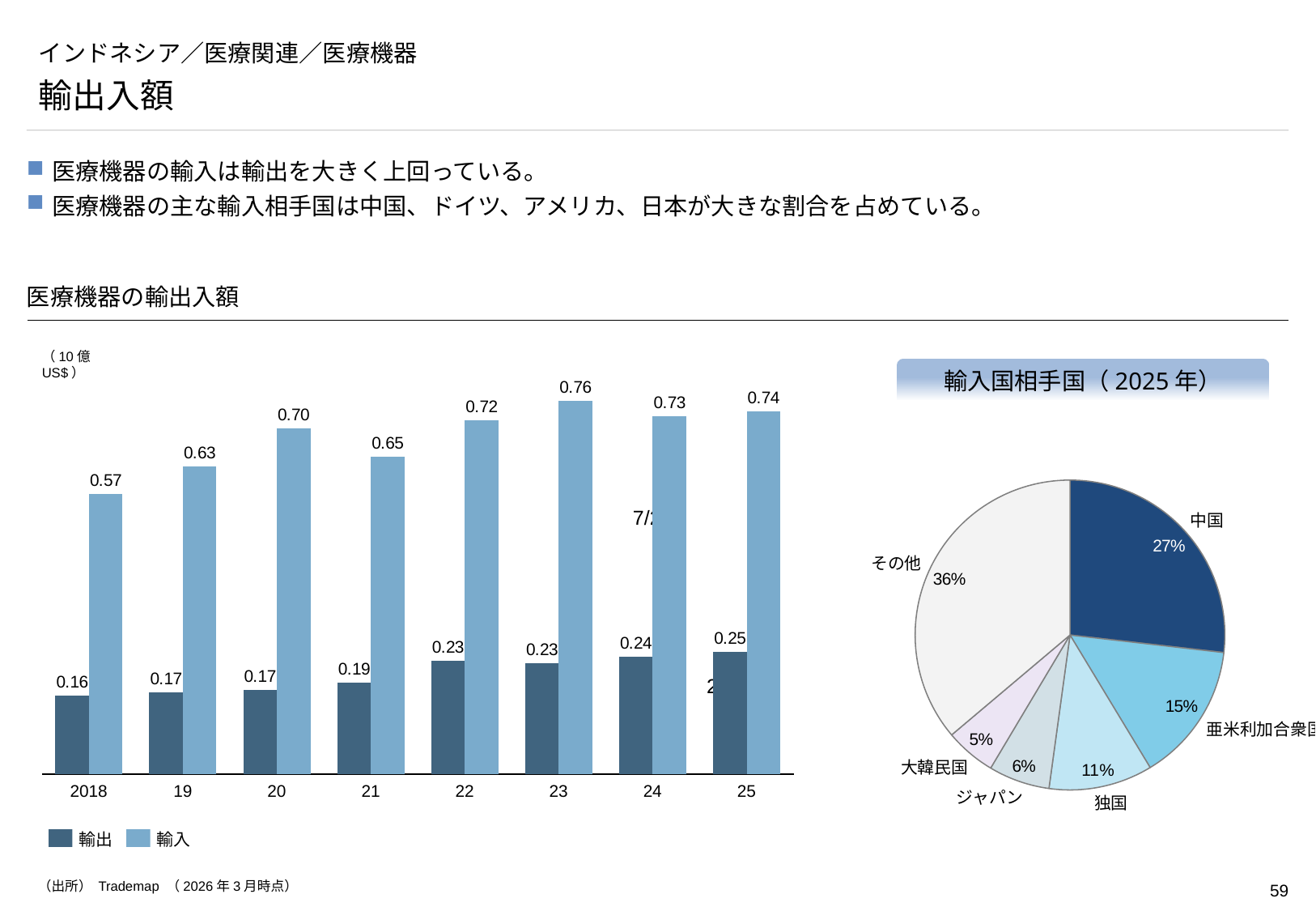
In the bar chart 医療機器の輸出入額, how many series does the legend list? 2 In the bar chart 医療機器の輸出入額, which year has the lowest 輸出 value? 2018 What kind of chart is 医療機器の輸出入額? bar chart In the bar chart 医療機器の輸出入額, is the 輸入 value for 20 larger or smaller than the 輸入 value for 21? larger In the bar chart 医療機器の輸出入額, how many years are shown on the x axis? 8 In the bar chart 医療機器の輸出入額, what is the difference between the 輸入 and 輸出 values for 25? 0.49 In the bar chart 医療機器の輸出入額, does the 輸出 value generally rise or fall from 2018 to 25? rise In the pie chart 輸入国相手国（2025年）, which named country has the smallest share? 大韓民国 In the bar chart 医療機器の輸出入額, which year has the highest 輸入 value? 23 In the bar chart 医療機器の輸出入額, what is the 輸出 value for 25? 0.25 In the pie chart 輸入国相手国（2025年）, what share does 中国 have? 27% In the bar chart 医療機器の輸出入額, what is the 輸入 value for 2018? 0.57